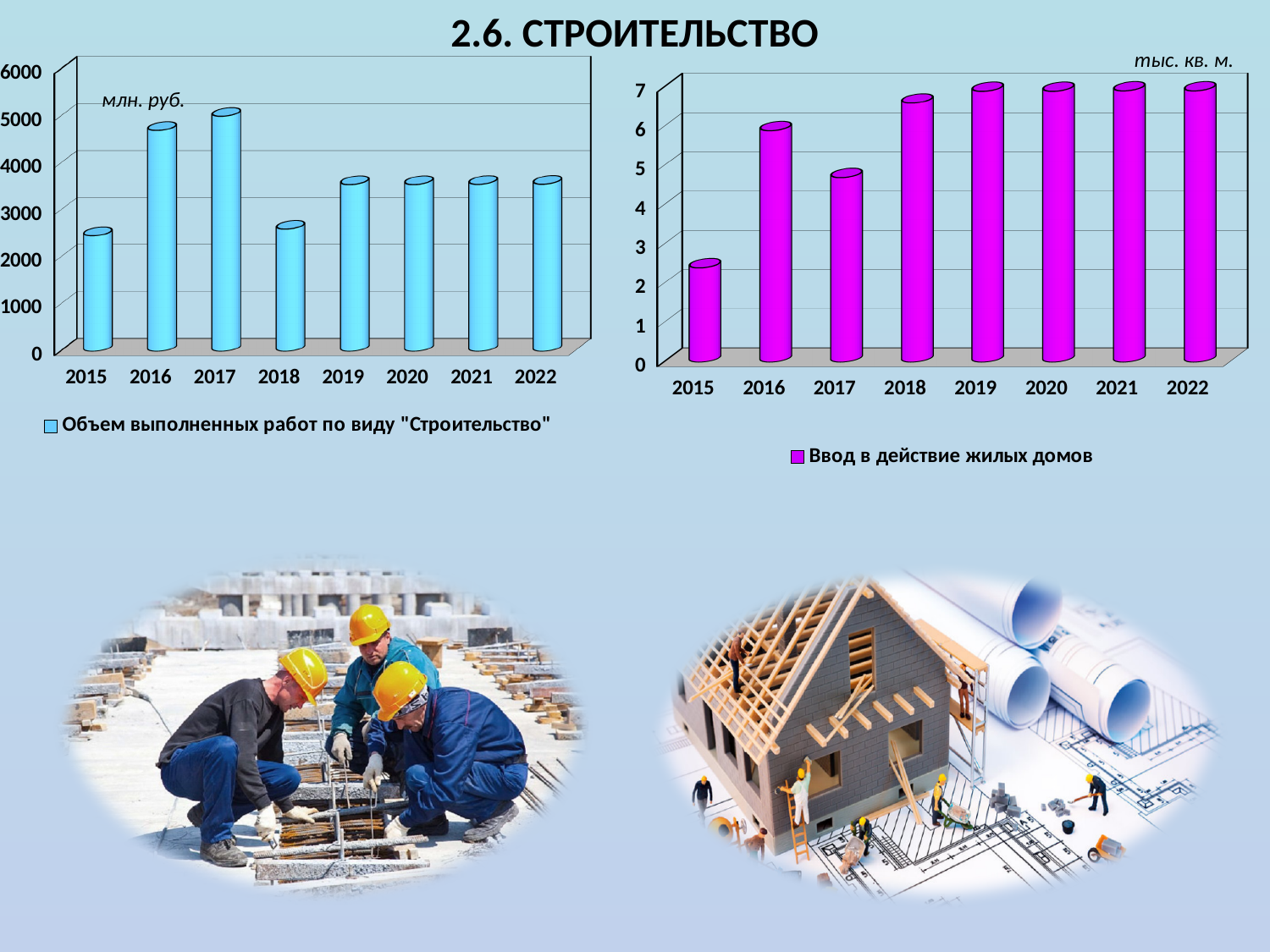
In the right chart (Ввод в действие жилых домов), is the value for 2018 greater or less than 6? greater In the right chart (Ввод в действие жилых домов), which year has the larger value, 2016 or 2017? 2016 In the left chart (Объем выполненных работ), is the value for 2016 greater or less than 4000? greater In the left chart (Объем выполненных работ), which year has the larger value, 2016 or 2018? 2016 In the left chart (Объем выполненных работ), which year has the highest value? 2017 In the left chart (Объем выполненных работ), is the value for 2015 greater or less than 3000? less How many years are shown on the x axis of the right chart (Ввод в действие жилых домов)? 8 What kind of chart is the left chart, "Объем выполненных работ по виду "Строительство""? bar chart How many series does the legend of the left chart list? 1 In the right chart (Ввод в действие жилых домов), which year has the lowest value? 2015 What unit is shown on the right chart (Ввод в действие жилых домов)? тыс. кв. м.